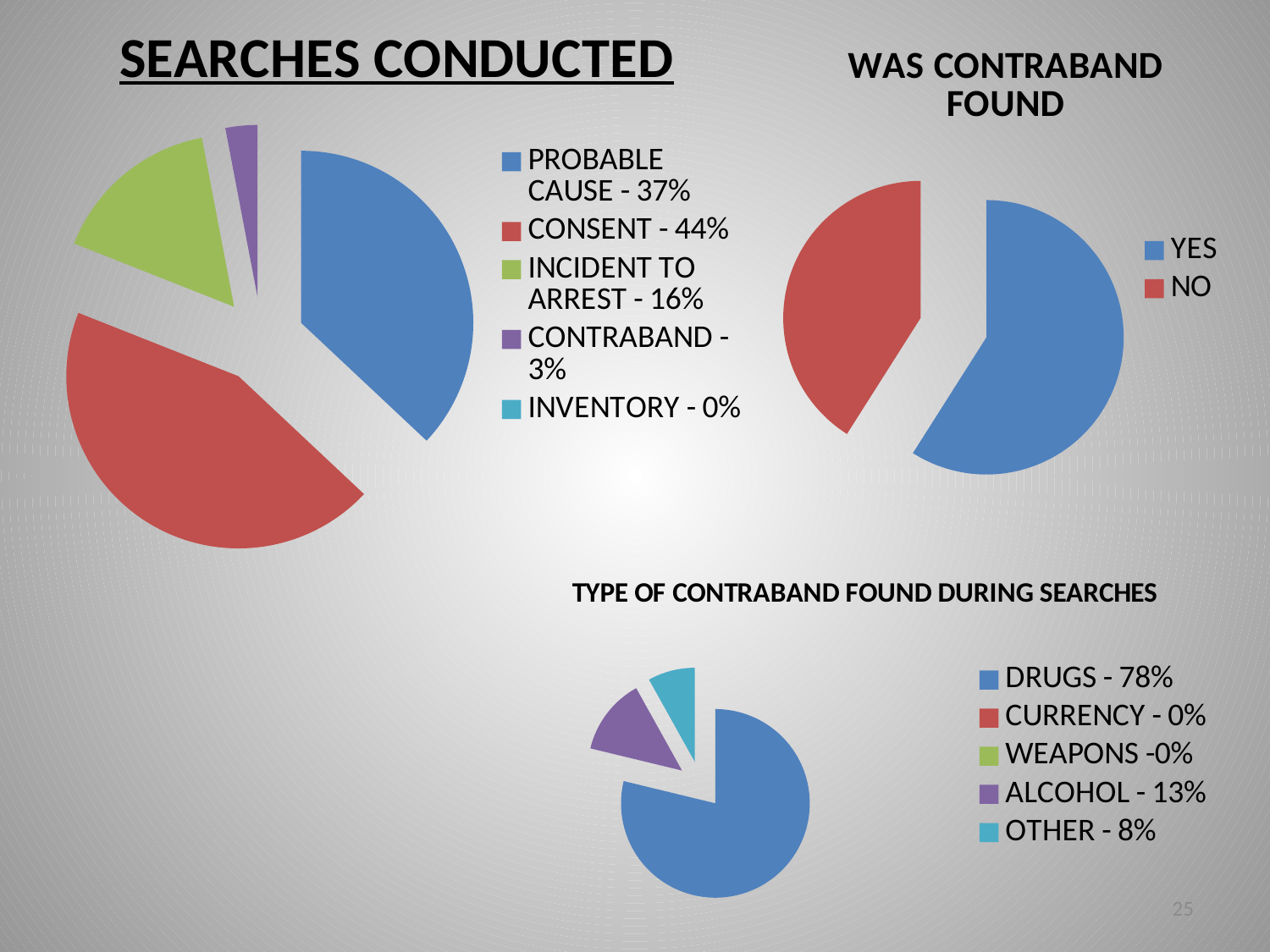
In the 'Searches Conducted' chart, what percentage of searches were by consent? 44% What kind of chart is the 'Was Contraband Found' chart? Pie chart In the 'Type of Contraband Found During Searches' chart, what colour is the drugs slice? Blue In the 'Type of Contraband Found During Searches' chart, what percentage is alcohol? 13% In the 'Type of Contraband Found During Searches' chart, what is the difference between the alcohol share and the other share? 5% In the 'Type of Contraband Found During Searches' chart, what percentage is drugs? 78% In the 'Searches Conducted' chart, how many categories does the legend list? 5 In the 'Was Contraband Found' chart, which slice is larger, YES or NO? YES In the 'Searches Conducted' chart, what percentage of searches were incident to arrest? 16% In the 'Searches Conducted' chart, what is the difference between the consent share and the probable cause share? 7% In the 'Searches Conducted' chart, which category has the largest share? CONSENT In the 'Was Contraband Found' chart, how many categories does the legend list? 2